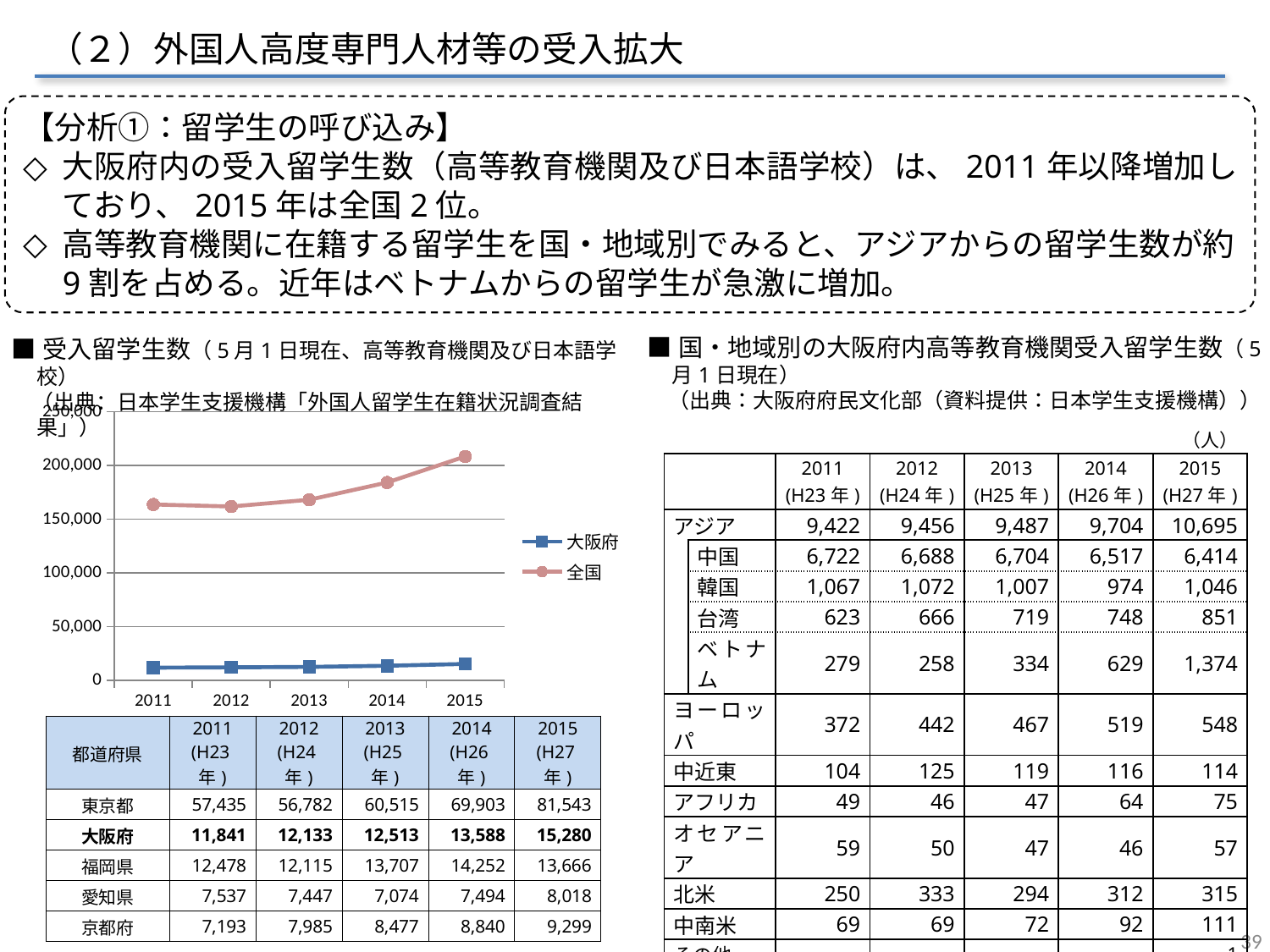
According to the table below the chart, what is the 大阪府 value for 2015? 15,280 In 2014, which series has the larger value, 大阪府 or 全国? 全国 Is the 全国 value for 2014 greater or less than 200,000? less In which year does the 全国 line reach its highest value? 2015 Is the 全国 value for 2011 greater or less than 150,000? greater How many series does the chart's legend list? 2 Is the 大阪府 value for 2015 greater or less than 50,000? less Which two series are listed in the chart's legend? 大阪府 and 全国 Does the 全国 line rise or fall from 2013 to 2015? rise How many years are plotted along the x axis of the chart? 5 What kind of chart is shown on the slide? line chart